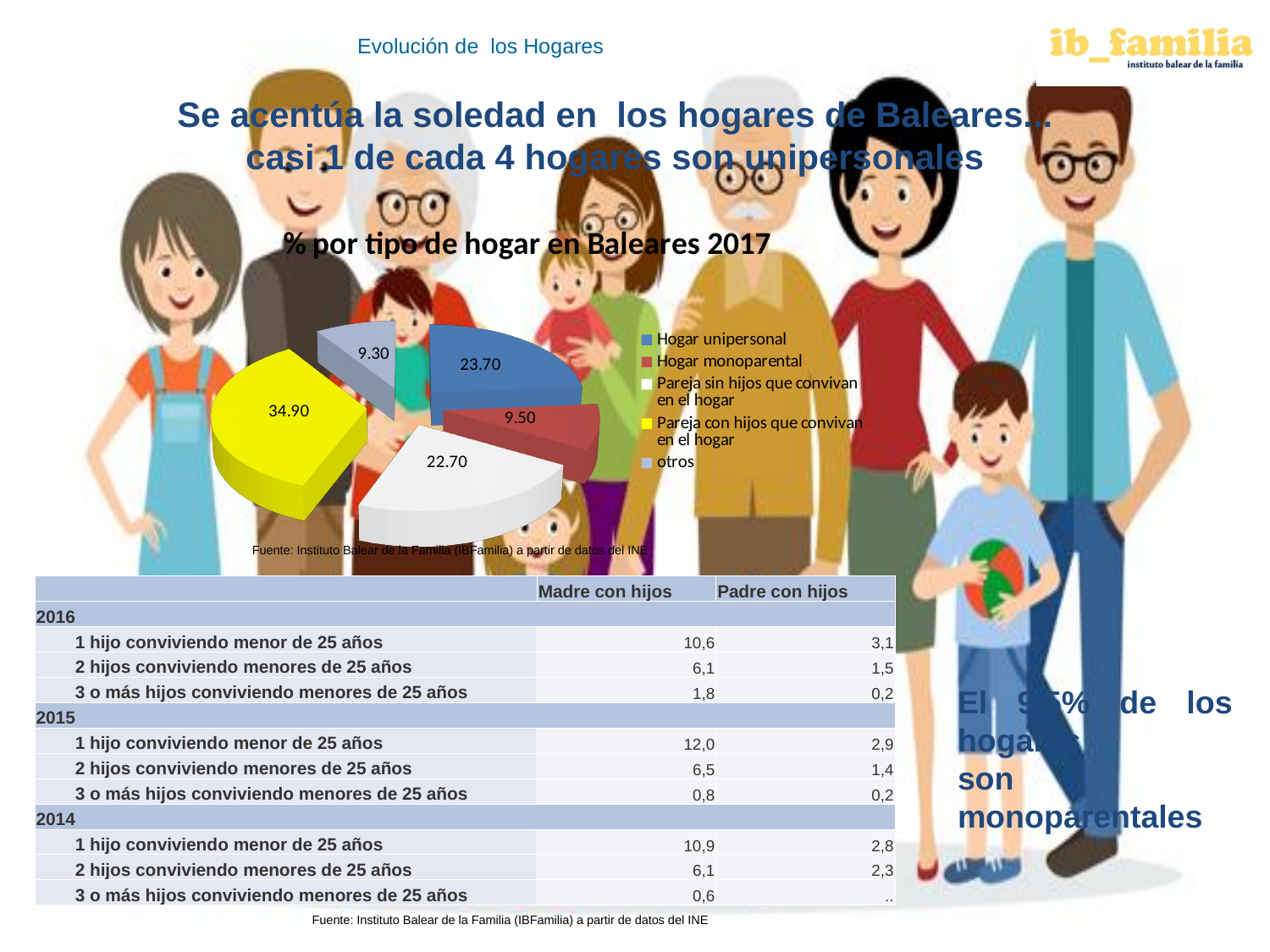
In the pie chart '% por tipo de hogar en Baleares 2017', which is larger: Hogar unipersonal or Pareja sin hijos que convivan en el hogar? Hogar unipersonal In the pie chart '% por tipo de hogar en Baleares 2017', what is the value for otros? 9.30 In the pie chart '% por tipo de hogar en Baleares 2017', what is the value for Pareja con hijos que convivan en el hogar? 34.90 In the pie chart '% por tipo de hogar en Baleares 2017', what is the difference between the values for Pareja con hijos que convivan en el hogar and Hogar unipersonal? 11.20 What kind of chart is shown under the heading '% por tipo de hogar en Baleares 2017'? Pie chart In the pie chart '% por tipo de hogar en Baleares 2017', what is the value for Hogar monoparental? 9.50 In the pie chart '% por tipo de hogar en Baleares 2017', what colour is the slice for Pareja con hijos que convivan en el hogar? Yellow How many slices does the pie chart '% por tipo de hogar en Baleares 2017' have? 5 In the pie chart '% por tipo de hogar en Baleares 2017', which household type has the largest share? Pareja con hijos que convivan en el hogar How many entries does the legend of the pie chart '% por tipo de hogar en Baleares 2017' list? 5 In the pie chart '% por tipo de hogar en Baleares 2017', which household type has the smallest share? otros In the pie chart '% por tipo de hogar en Baleares 2017', what is the value for Hogar unipersonal? 23.70